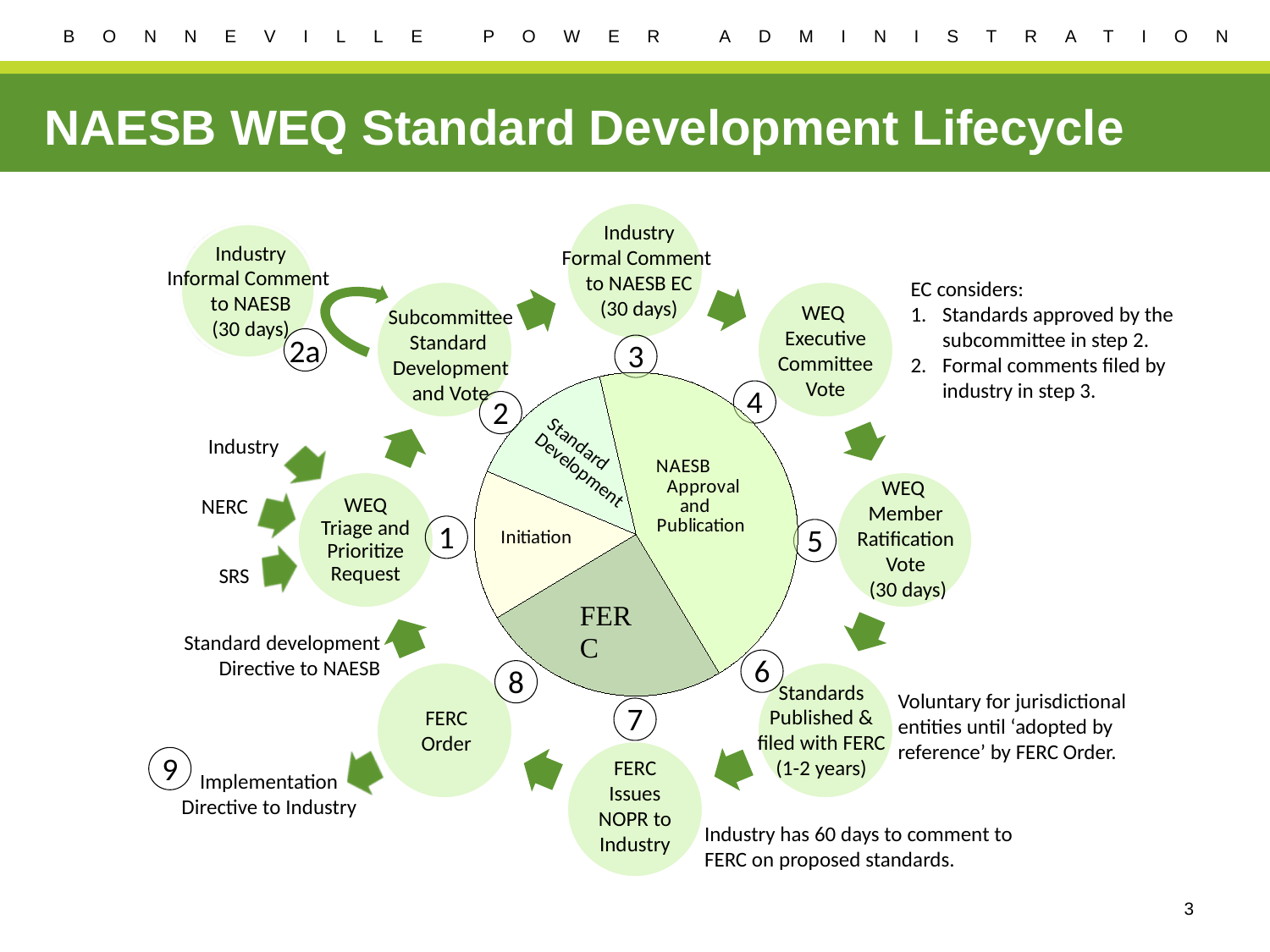
Which slice of the pie chart is larger, FERC or NAESB Approval and Publication? NAESB Approval and Publication What kind of chart is shown in the center of the slide? pie chart What is the title of the slide containing the pie chart? NAESB WEQ Standard Development Lifecycle Which slice of the pie chart is the largest? NAESB Approval and Publication How many slices does the pie chart in the center of the slide have? 4 Which slice of the pie chart is larger, FERC or Initiation? FERC Which slice of the pie chart is shaded the darkest green? FERC